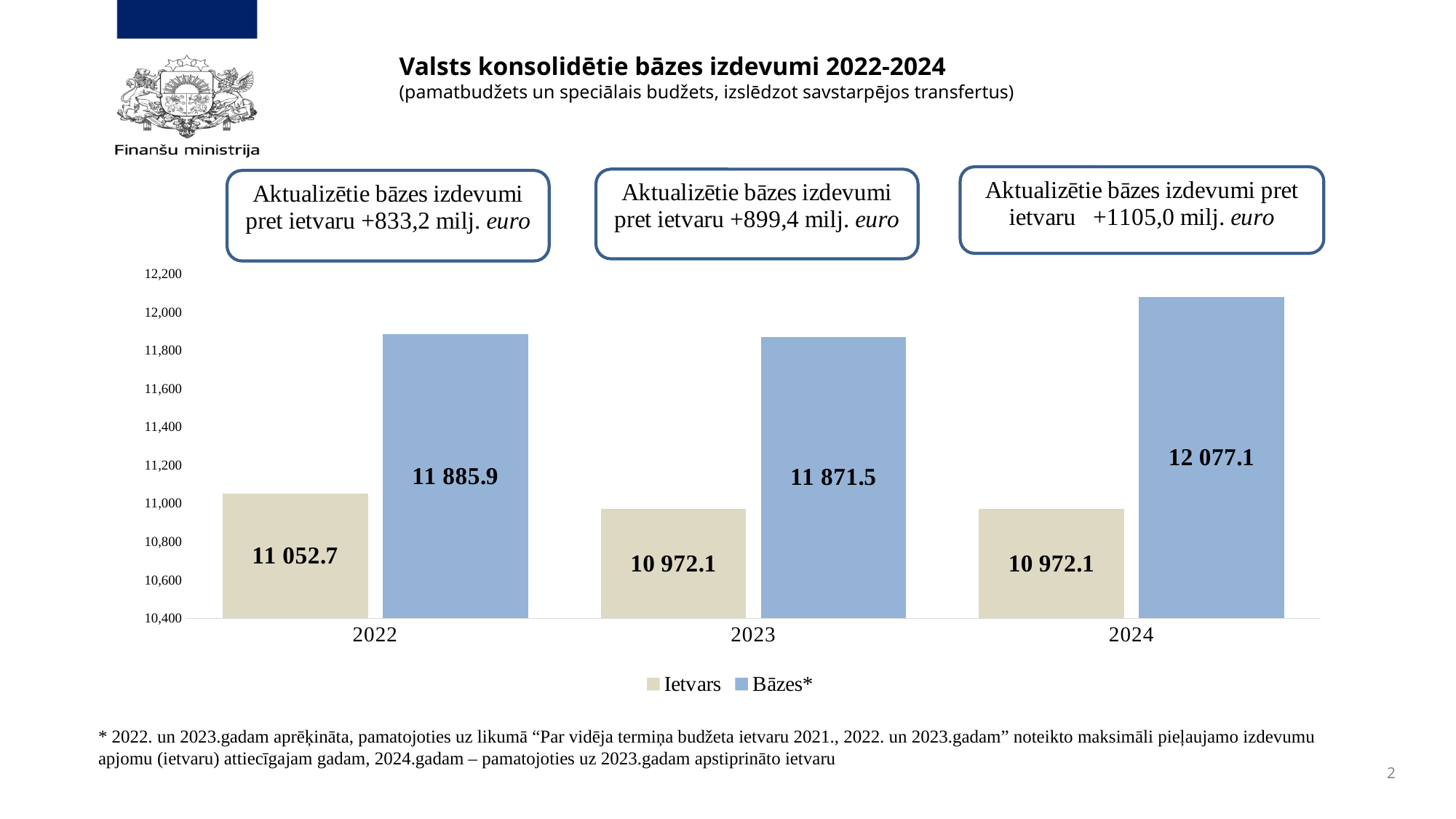
What is the difference between the Bāzes* and Ietvars values for 2024? 1 105.0 In which year is the Bāzes* value highest? 2024 What is the Bāzes* value for 2023? 11 871.5 What is the Bāzes* value for 2024? 12 077.1 In which year is the Ietvars value highest? 2022 How many years (categories) are shown on the x axis? 3 How many series does the legend list? 2 Which is larger, the Ietvars value for 2022 or the Ietvars value for 2023? 2022 Is the Bāzes* value for 2024 greater or less than 12,000? greater What type of chart is shown on the slide? bar chart What is the Ietvars value for 2022? 11 052.7 What is the Ietvars value for 2024? 10 972.1